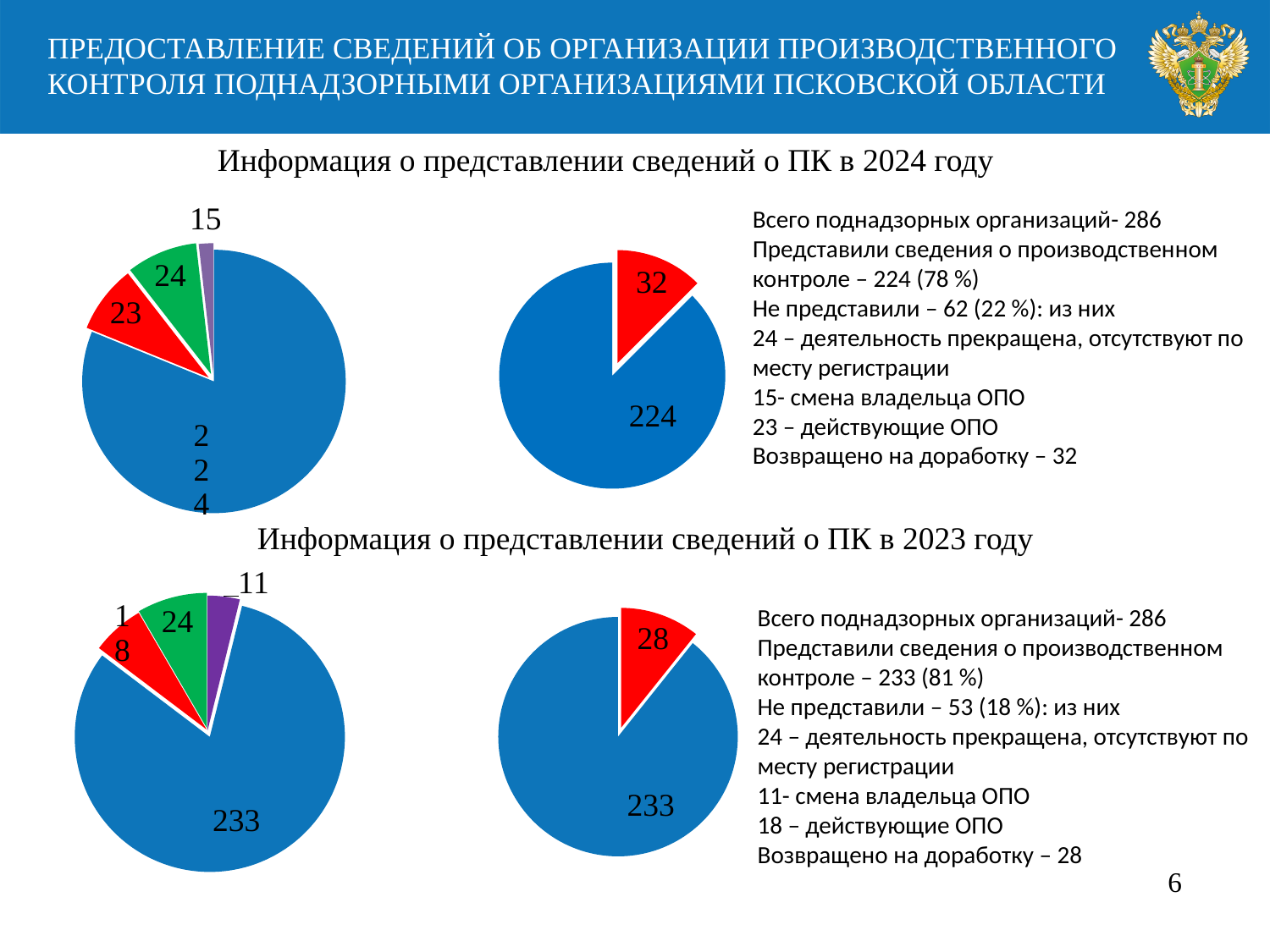
What kind of chart is the top-left chart under "Информация о представлении сведений о ПК в 2024 году"? pie chart In the top-left pie chart (2024 section), what value is labelled on the purple slice? 15 How many slices does the top-left pie chart (2024 section) have? 4 In the bottom-left pie chart (2023 section), what value is labelled on the green slice? 24 In the top-right pie chart (2024 section), what share of the total does the red slice (32) represent? 12.5% In the top-left pie chart (2024 section), which slice has the smallest value? the purple slice (15) Which is larger: the red slice in the top-right pie chart (2024) or the red slice in the bottom-right pie chart (2023)? the top-right (2024) red slice, 32 How many slices does the bottom-left pie chart (2023 section) have? 4 In the top-right pie chart (2024 section), what value is labelled on the red slice? 32 In the top-left pie chart (2024 section), what value is labelled on the large blue slice? 224 In the top-right pie chart (2024 section), what is the difference between the blue slice and the red slice? 192 In the bottom-right pie chart (2023 section), what value is labelled on the red slice? 28